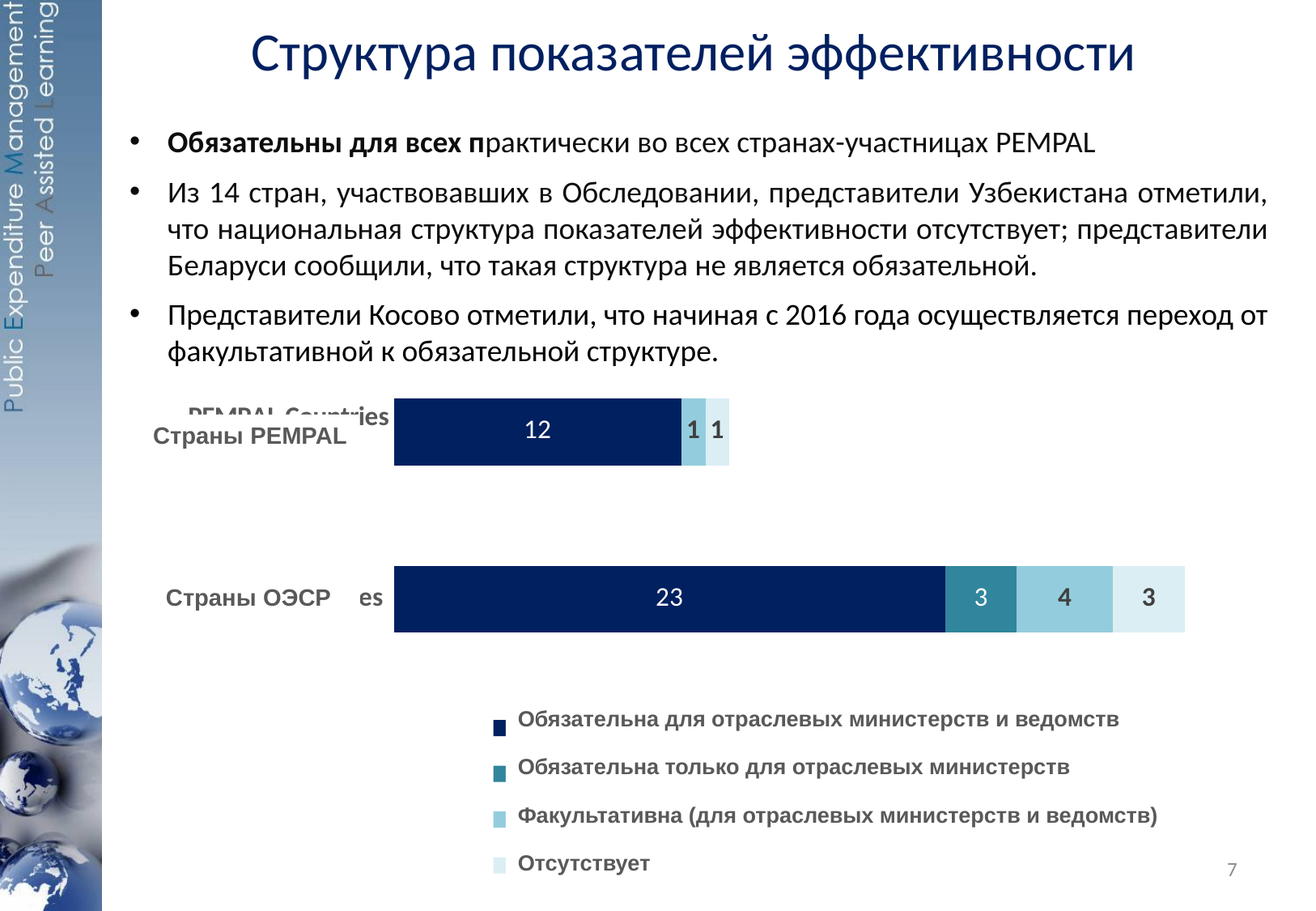
What kind of chart is shown on the slide? Stacked bar chart What is the difference between the 'Обязательна для отраслевых министерств и ведомств' values for Страны ОЭСР and Страны PEMPAL? 11 What is the value of the 'Обязательна для отраслевых министерств и ведомств' segment for Страны ОЭСР? 23 What is the value of the 'Обязательна для отраслевых министерств и ведомств' segment for Страны PEMPAL? 12 How many series does the legend list? 4 What is the total of the stacked bar for Страны PEMPAL? 14 What is the value of the 'Факультативна (для отраслевых министерств и ведомств)' segment for Страны ОЭСР? 4 Which legend entry is shown in the darkest colour? Обязательна для отраслевых министерств и ведомств How many categories (country groups) does the chart show? 2 What is the value of the 'Отсутствует' segment for Страны PEMPAL? 1 What is the total of the stacked bar for Страны ОЭСР? 33 What is the value of the 'Отсутствует' segment for Страны ОЭСР? 3